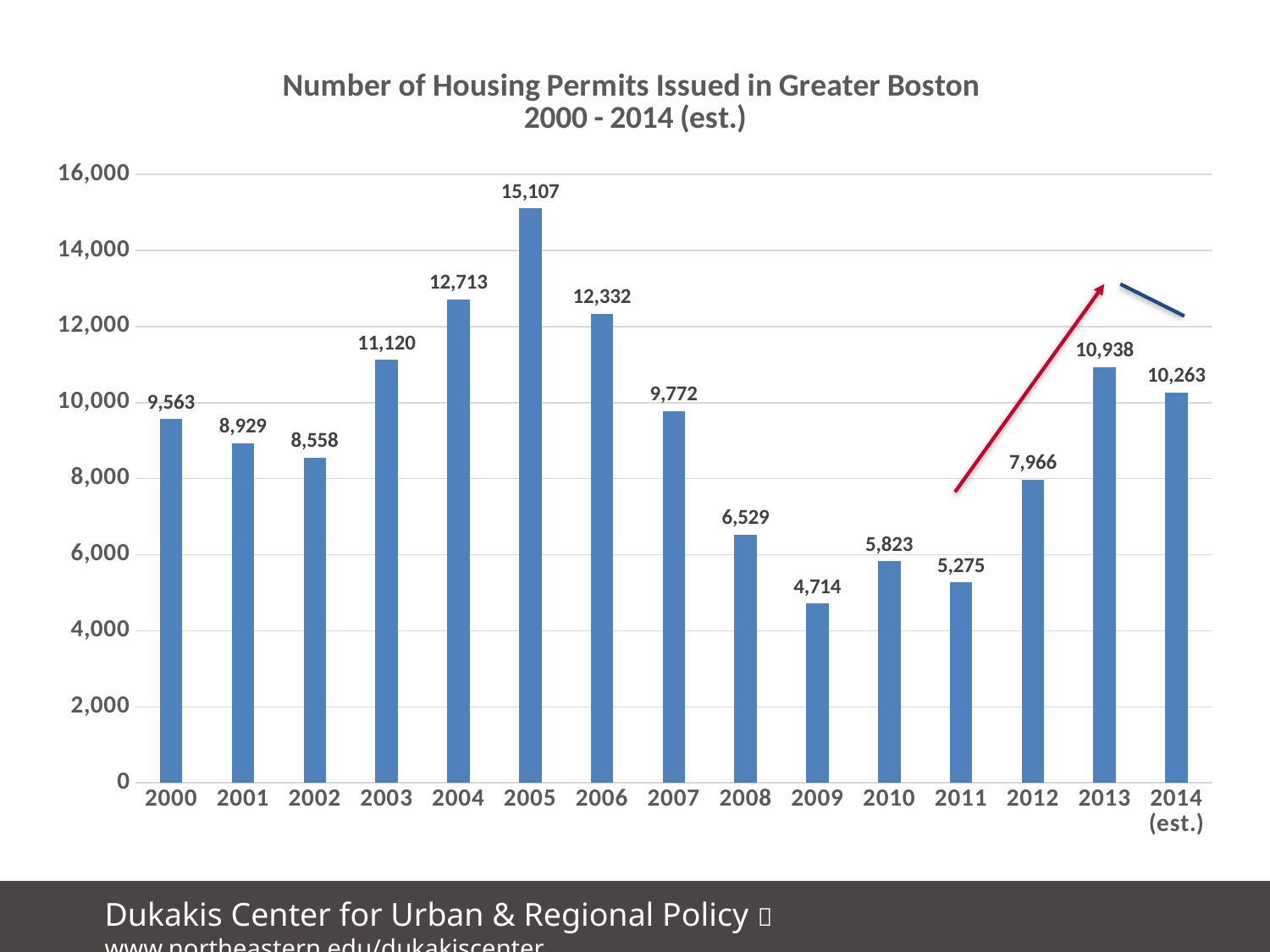
What is the value shown for 2009? 4,714 Which year has the highest number of housing permits? 2005 Is the value for 2011 greater or less than 6,000? less What is the difference between the 2013 value and the 2012 value? 2,972 How many housing permits were issued in Greater Boston in 2005? 15,107 What is the estimated number of housing permits for 2014? 10,263 Which year has the lowest number of housing permits? 2009 What is the title of the chart? Number of Housing Permits Issued in Greater Boston 2000 - 2014 (est.) How many years are shown on the x axis? 15 Do the values rise or fall from 2005 to 2009? fall What kind of chart is shown on the slide? bar chart Which year had more housing permits, 2004 or 2006? 2004